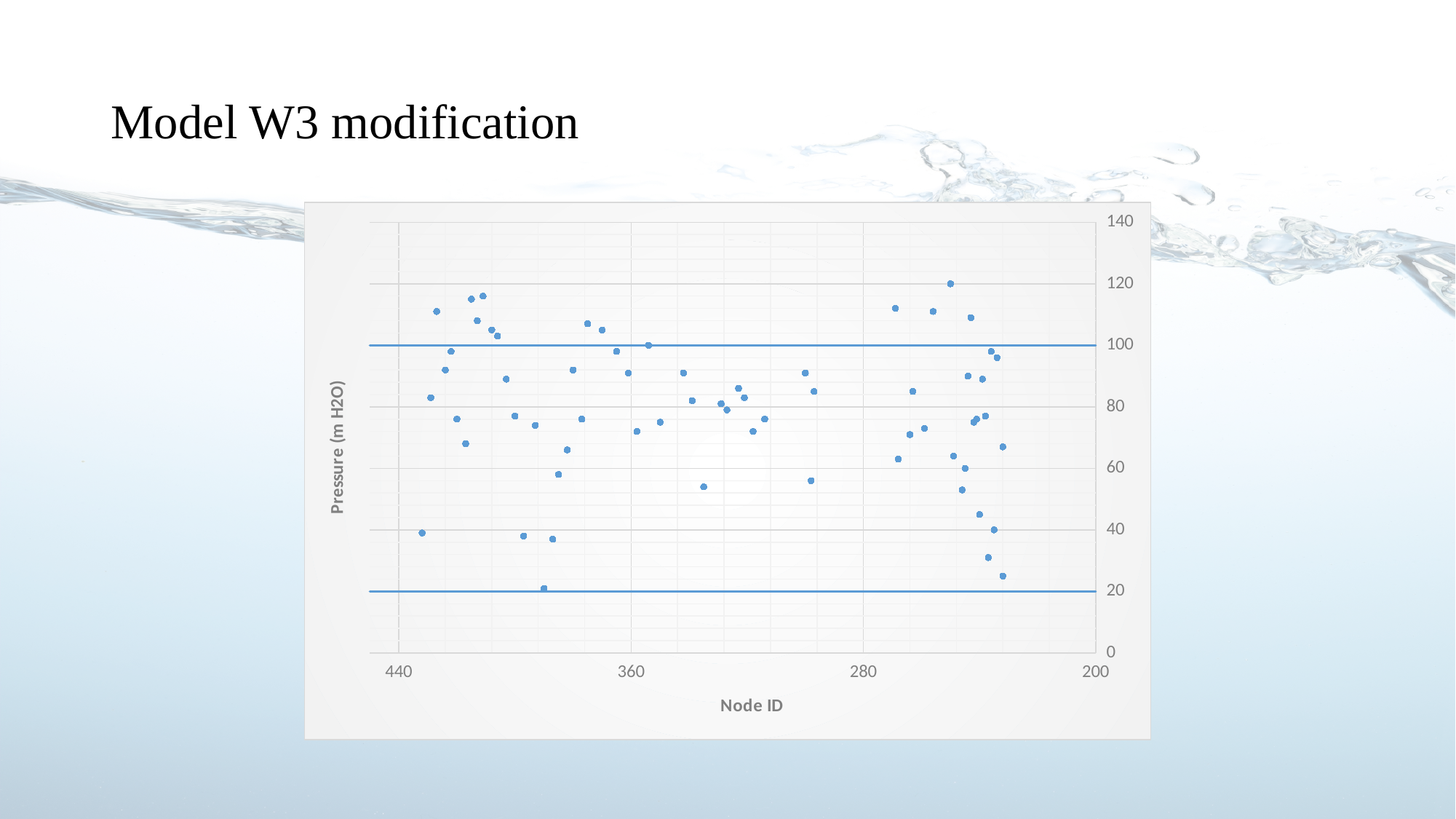
Is the highest plotted pressure value greater or less than 100? greater What is the maximum value shown on the vertical axis? 140 Is the lowest plotted pressure value greater or less than 40? less What is the title of the vertical axis of the chart? Pressure (m H2O) Is the highest plotted pressure value greater or less than 140? less What is the leftmost value shown on the horizontal axis? 440 What is the title of the horizontal axis of the chart? Node ID What is the rightmost value shown on the horizontal axis? 200 What kind of chart is shown on the slide? scatter chart How many horizontal reference lines are drawn across the chart? 2